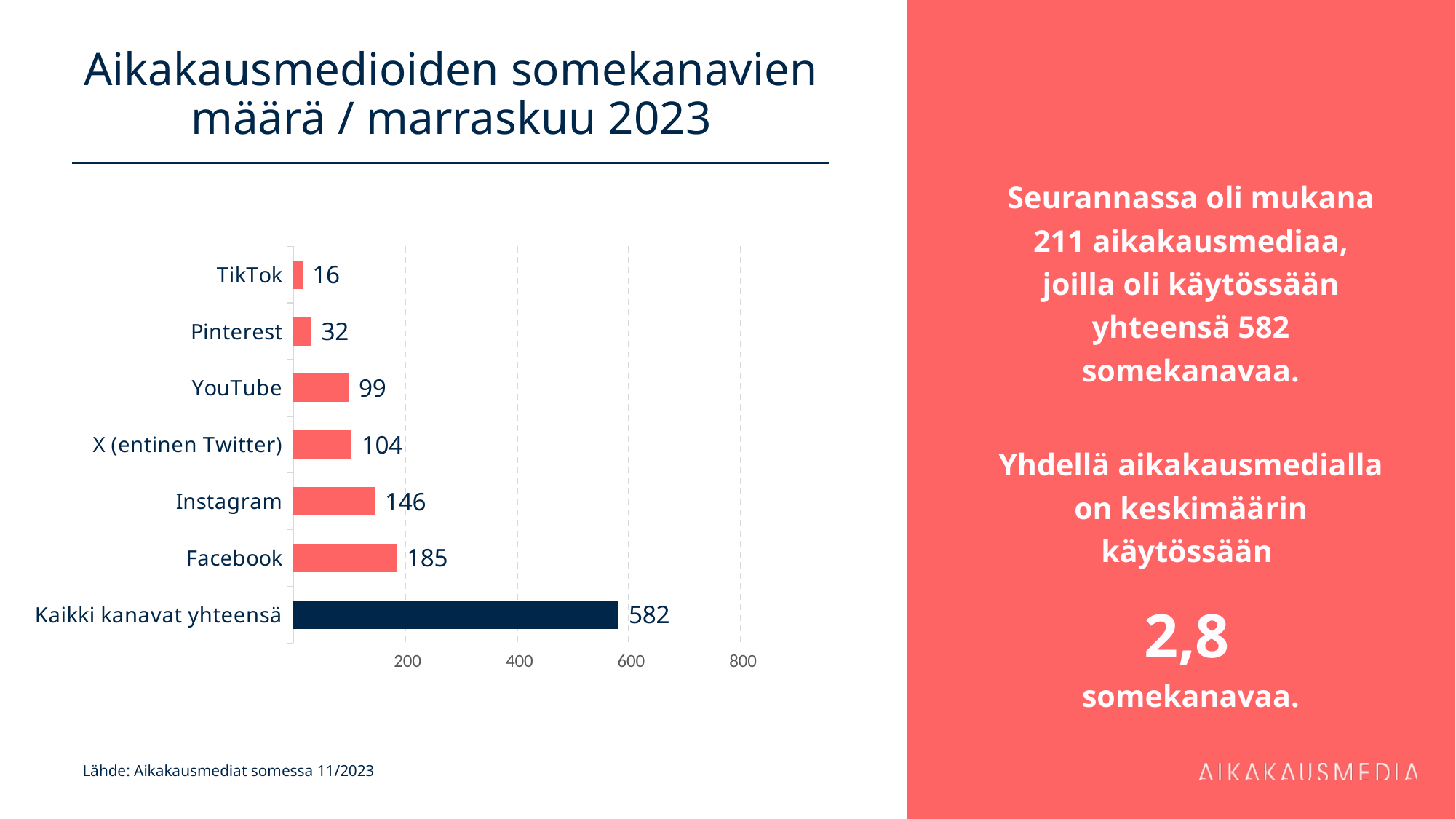
What kind of chart is shown on the slide? bar chart How many categories are shown in the chart? 7 What is the value for TikTok? 16 What is the value for Facebook? 185 Which individual channel (excluding the total bar) has the highest value? Facebook What is the difference between the values for Facebook and Instagram? 39 Is the value for Instagram greater or less than 200? less What is the value for X (entinen Twitter)? 104 Which category has the lowest value? TikTok Which is larger, the value for YouTube or the value for X (entinen Twitter)? X (entinen Twitter) What is the title of the chart? Aikakausmedioiden somekanavien määrä / marraskuu 2023 What is the value for Kaikki kanavat yhteensä? 582